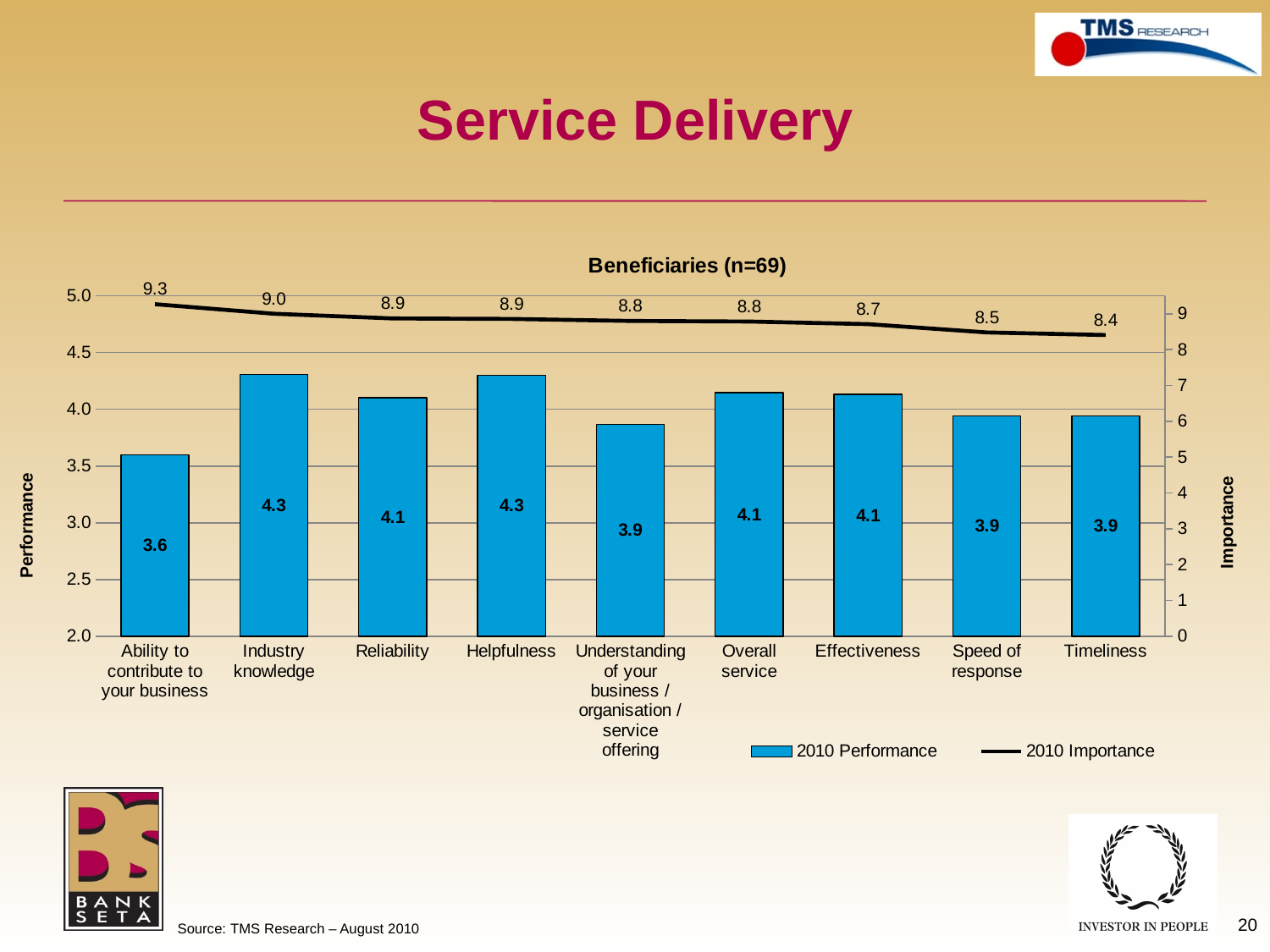
Which has the higher 2010 Performance value: Industry knowledge or Understanding of your business / organisation / service offering? Industry knowledge What is the difference between the 2010 Importance values for Industry knowledge and Speed of response? 0.5 Which category has the lowest 2010 Performance value? Ability to contribute to your business How many series does the legend list? 2 Does the 2010 Importance line rise or fall from left to right across the categories? Falls Which category has the lowest 2010 Importance value? Timeliness What is the 2010 Performance value for Reliability? 4.1 How many categories are shown on the x axis of the chart? 9 What is the difference between the 2010 Importance and 2010 Performance values for Ability to contribute to your business? 5.7 Which category has the highest 2010 Importance value? Ability to contribute to your business What is the 2010 Importance value for Effectiveness? 8.7 What is the 2010 Importance value for Timeliness? 8.4